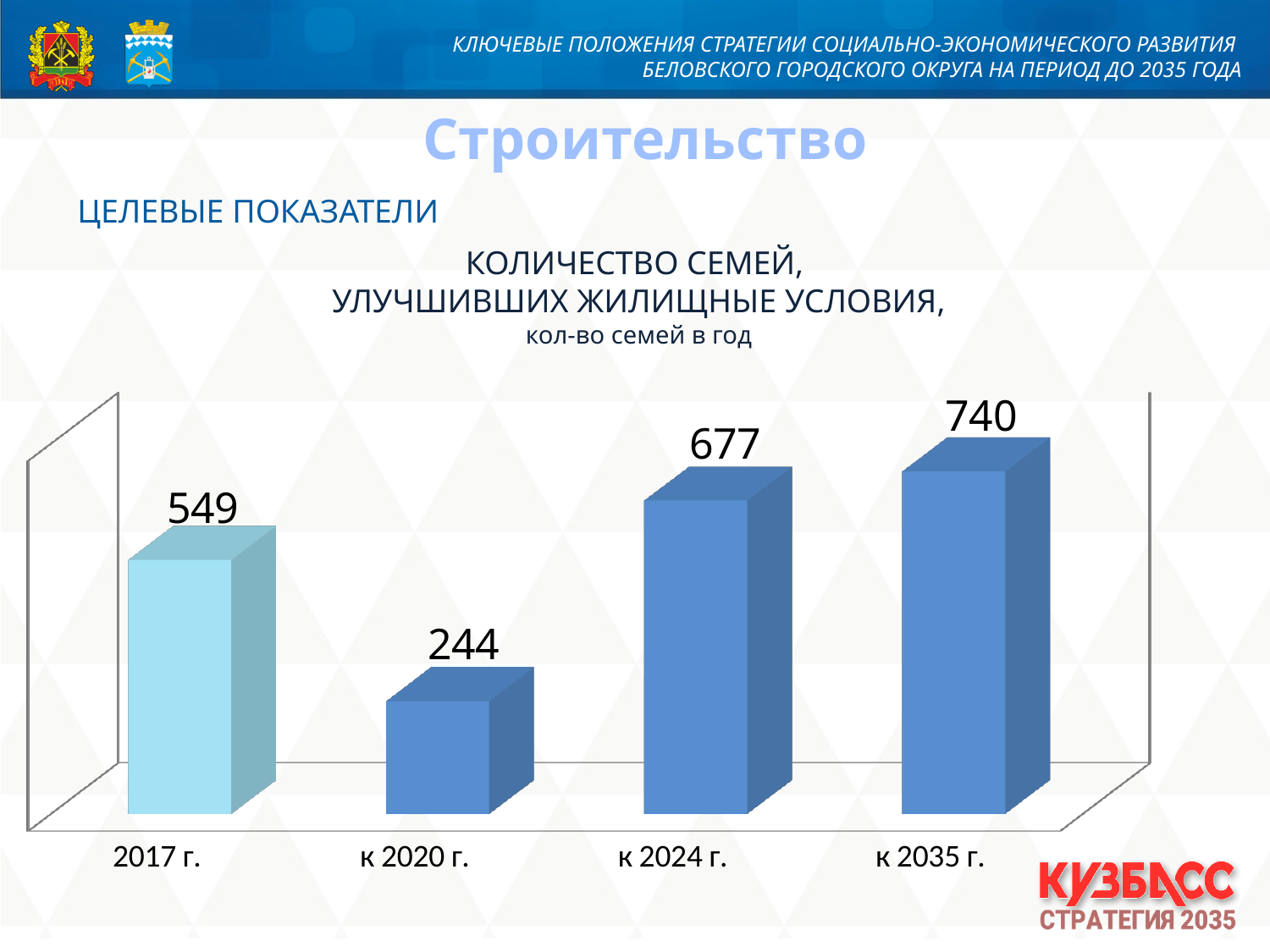
Which is larger, the value for 2017 г. or the value for к 2024 г.? к 2024 г. Which category has the highest value? к 2035 г. How many categories are shown on the chart? 4 What kind of chart is shown on the slide? bar chart What is the difference between the values for к 2024 г. and к 2020 г.? 433 Which category has the lowest value? к 2020 г. What is the value for к 2024 г.? 677 What is the difference between the values for к 2035 г. and 2017 г.? 191 What is the value for к 2020 г.? 244 What unit is stated under the chart title? кол-во семей в год What is the value for к 2035 г.? 740 What is the value for 2017 г.? 549